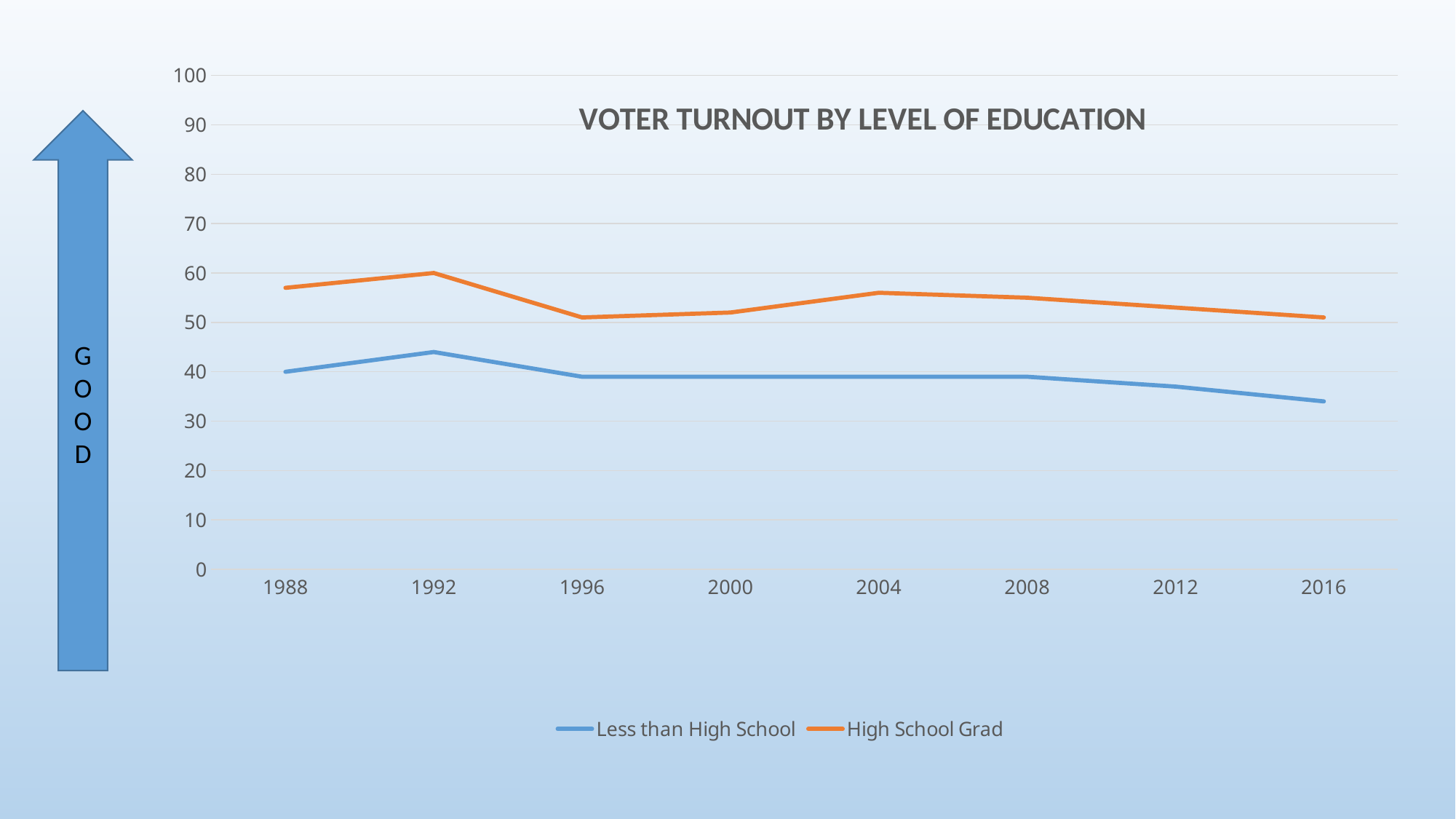
How many series does the legend list? 2 What is the value for High School Grad in 1992? 60 Does the Less than High School series rise or fall from 2008 to 2016? fall What is the title of the chart? VOTER TURNOUT BY LEVEL OF EDUCATION In which year is the Less than High School series lowest? 2016 What is the value for Less than High School in 1988? 40 Which series is drawn in orange? High School Grad What kind of chart is shown on the slide? line chart Is the value for Less than High School in 2016 greater or less than 40? less How many years are plotted along the x axis? 8 In which year is the High School Grad series highest? 1992 Which series has the higher value in 2004, Less than High School or High School Grad? High School Grad